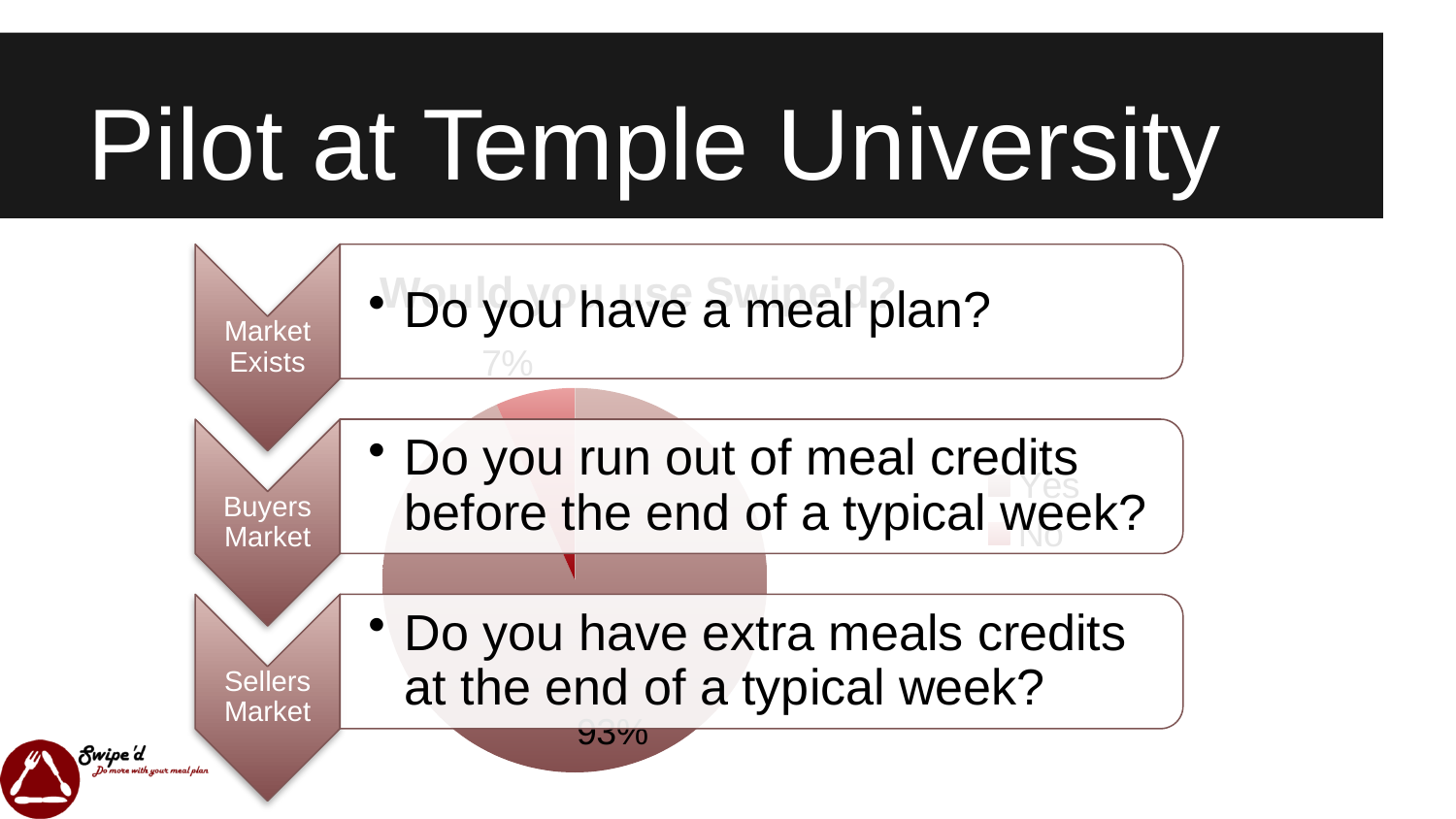
How many entries does the pie chart's legend list? 2 How many slices does the pie chart have? 2 What is the title of the pie chart? Would you use Swipe'd? What is the difference between the two slice values shown on the pie chart? 86% What are the legend entries of the pie chart? Yes, No What kind of chart is shown on the slide? pie chart What is the value of the largest slice of the pie chart? 93% Is the largest slice of the pie chart greater or less than 50%? greater What is the value of the smallest slice of the pie chart? 7% Do the two slice values shown on the pie chart add up to 100%? Yes